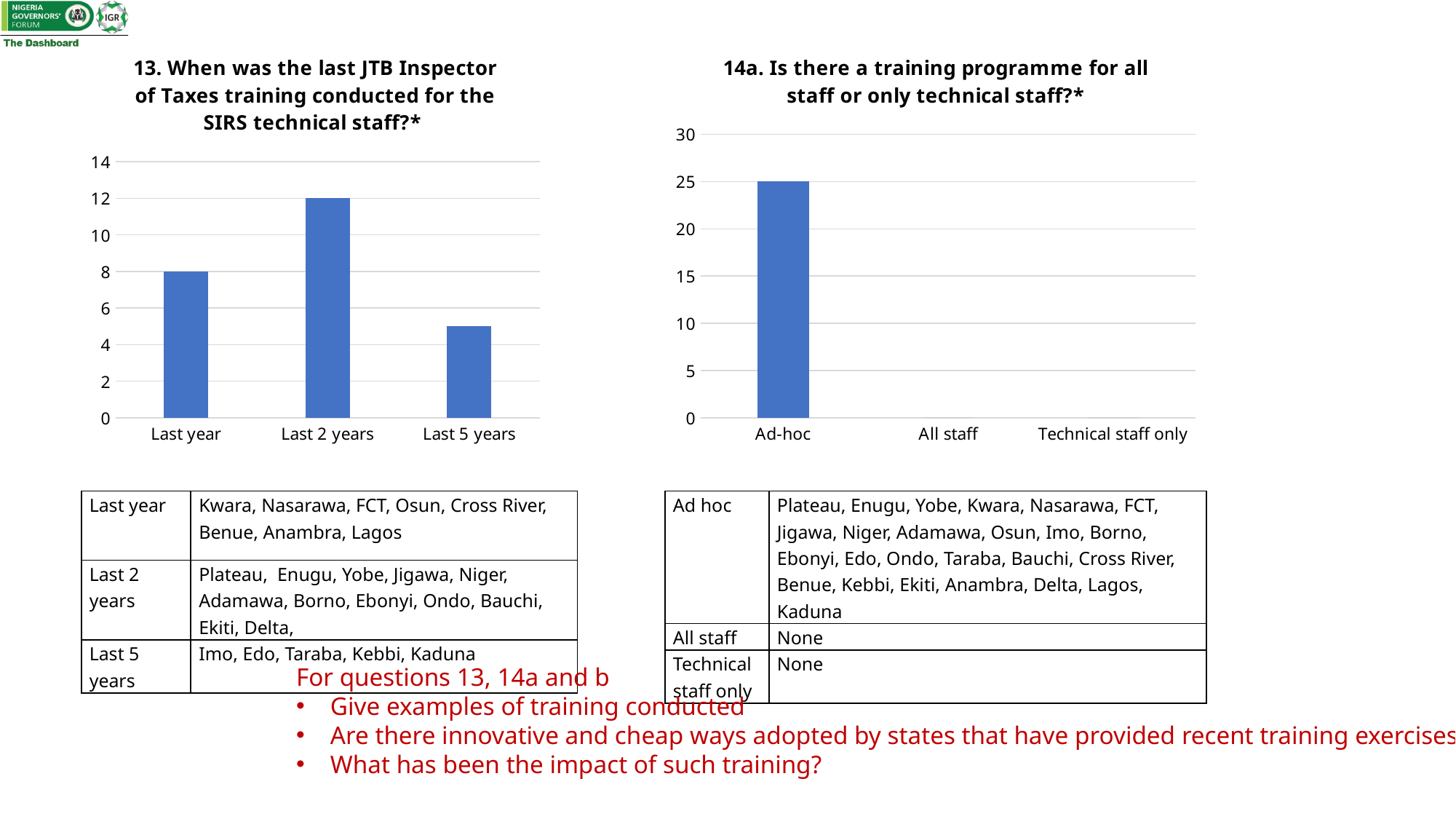
In the chart titled '13. When was the last JTB Inspector of Taxes training conducted for the SIRS technical staff?*', what is the difference between the values for 'Last 2 years' and 'Last year'? 4 In the chart titled '13. When was the last JTB Inspector of Taxes training conducted for the SIRS technical staff?*', which category has the lowest value? Last 5 years In the chart titled '13. When was the last JTB Inspector of Taxes training conducted for the SIRS technical staff?*', how many categories are shown on the x axis? 3 In the chart titled '13. When was the last JTB Inspector of Taxes training conducted for the SIRS technical staff?*', what is the value for 'Last 2 years'? 12 In the chart titled '14a. Is there a training programme for all staff or only technical staff?*', which category has the highest value? Ad-hoc In the chart titled '13. When was the last JTB Inspector of Taxes training conducted for the SIRS technical staff?*', what is the value for 'Last year'? 8 What type of chart is the chart titled '14a. Is there a training programme for all staff or only technical staff?*'? bar chart In the chart titled '14a. Is there a training programme for all staff or only technical staff?*', how many categories are shown on the x axis? 3 In the chart titled '13. When was the last JTB Inspector of Taxes training conducted for the SIRS technical staff?*', is the value for 'Last 5 years' greater or less than 6? less In the chart titled '14a. Is there a training programme for all staff or only technical staff?*', is the value for 'Ad-hoc' greater or less than 20? greater In the chart titled '14a. Is there a training programme for all staff or only technical staff?*', what is the value for 'Ad-hoc'? 25 In the chart titled '13. When was the last JTB Inspector of Taxes training conducted for the SIRS technical staff?*', which category has the highest value? Last 2 years